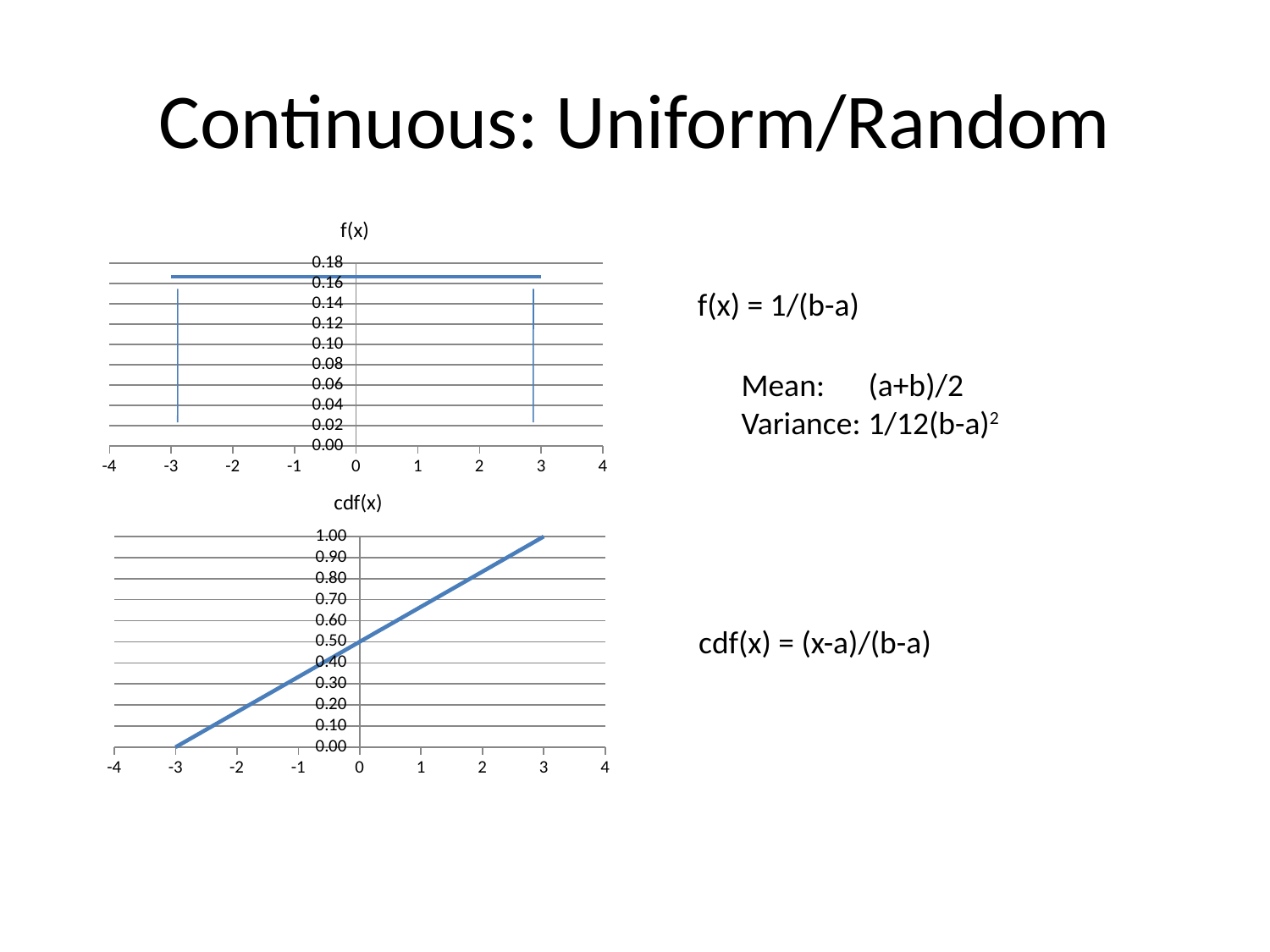
In the top chart f(x), is the value of the horizontal line at x = 0 greater or less than 0.18? less In the bottom chart cdf(x), is the value at x = 2 greater or less than 0.70? greater How many charts are shown on the slide? 2 What kind of chart is the bottom chart titled cdf(x)? line chart What is the title of the bottom chart? cdf(x) In the bottom chart cdf(x), at what x value does the line reach 1.00? 3 What kind of chart is the top chart titled f(x)? line chart In the bottom chart cdf(x), is the value at x = -2 greater or less than 0.30? less In the top chart f(x), does the horizontal line rise, fall, or stay flat between x = -3 and x = 3? stay flat In the bottom chart cdf(x), do the values rise or fall as x increases from -3 to 3? rise In the bottom chart cdf(x), what is the highest value shown on the y axis? 1.00